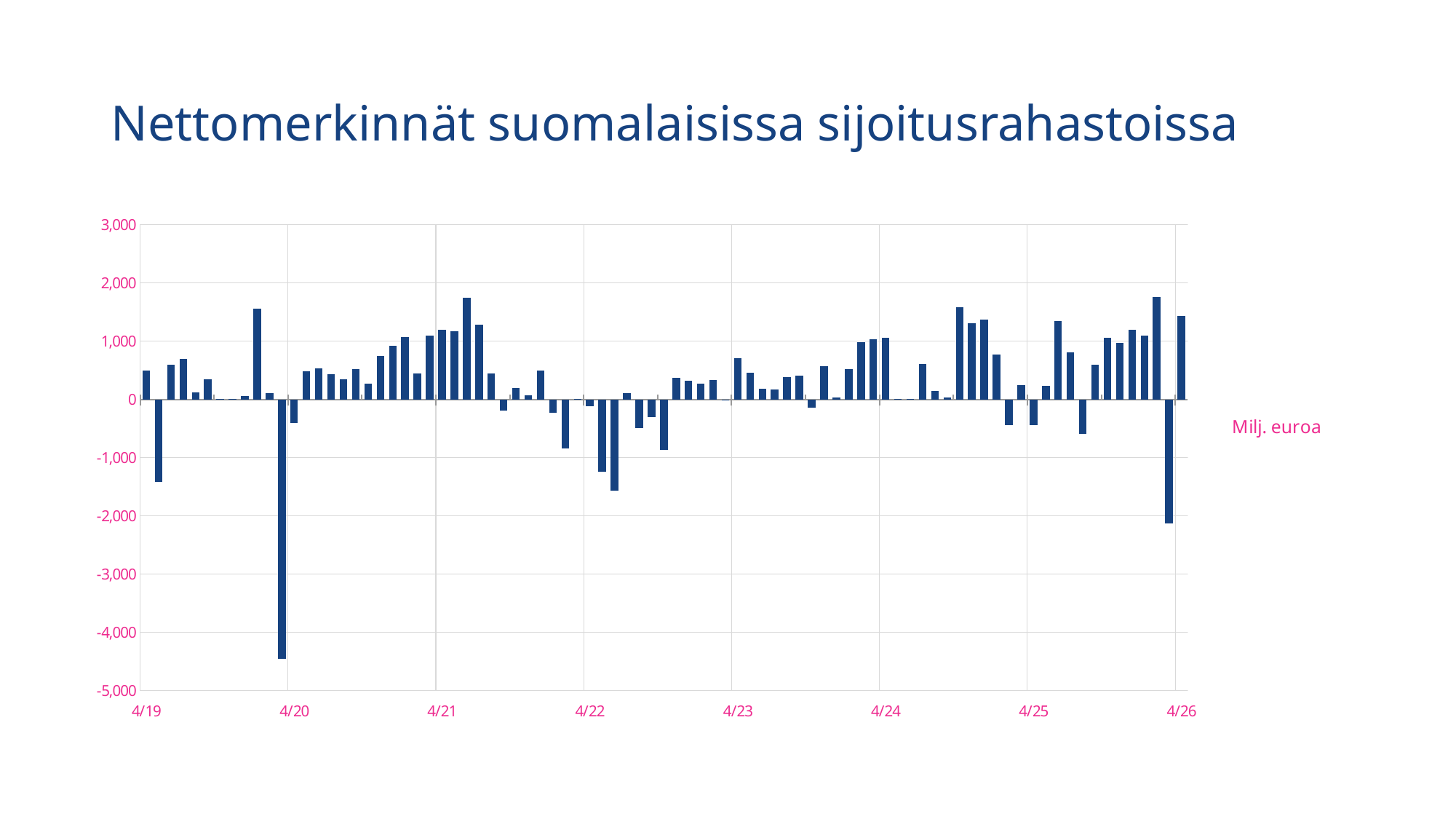
Which bar is larger, the one at 4/19 or the one at 4/26? 4/26 Is the value of the bar at 4/23 greater or less than 0? greater What kind of chart is shown on the slide? bar chart Near which x-axis label does the lowest bar in the chart occur? 4/20 How many labels are shown on the x axis? 8 Is the value of the bar at 4/25 greater or less than 0? less Is the value of the bar at 4/26 greater or less than 1,000? greater What is the lowest value shown on the y axis? -5,000 What is the title of the chart? Nettomerkinnät suomalaisissa sijoitusrahastoissa What is the highest value shown on the y axis? 3,000 What unit label is shown next to the chart? Milj. euroa